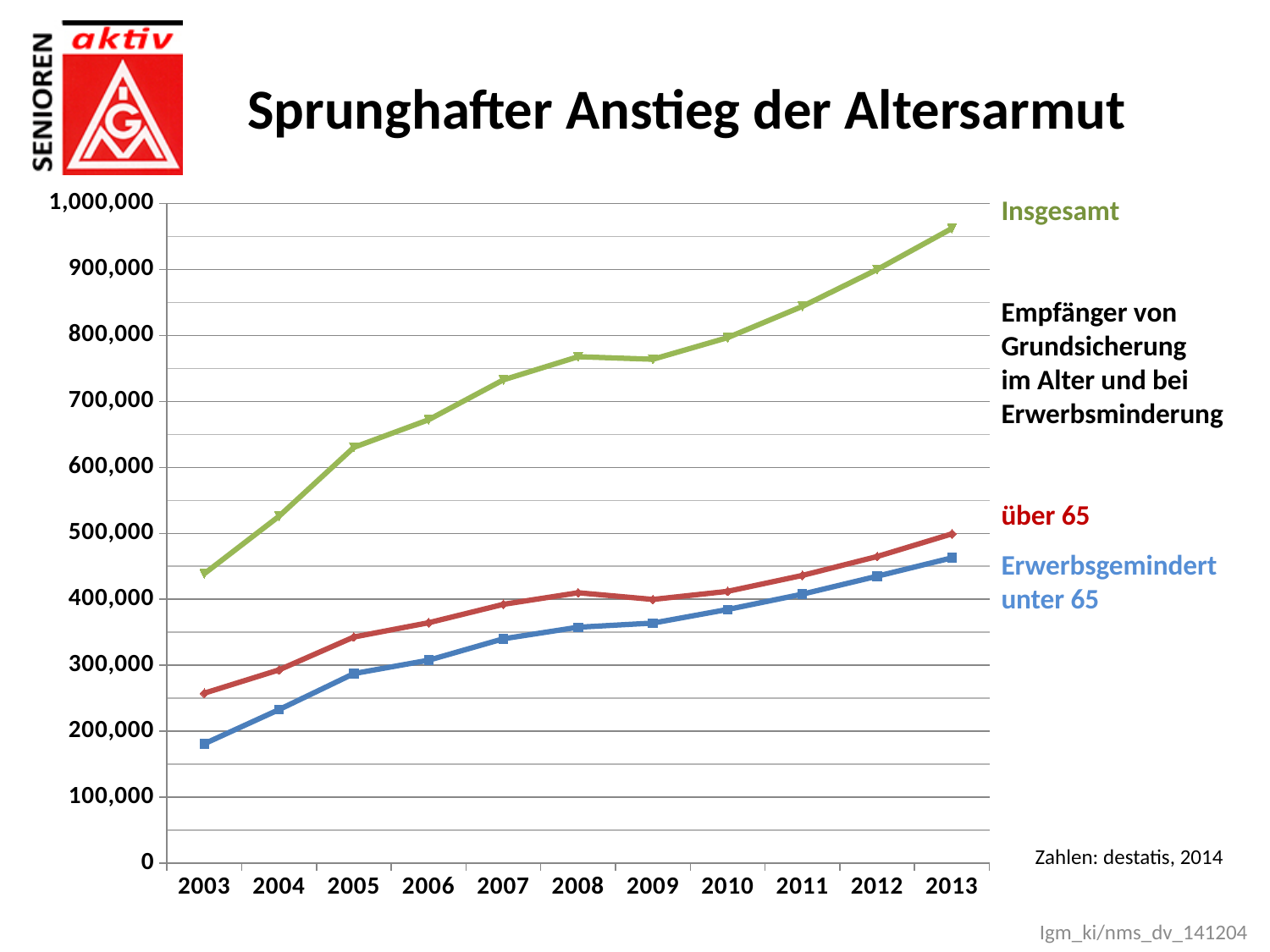
Is the Insgesamt value for 2003 greater or less than 500,000? less Is the Erwerbsgemindert unter 65 value for 2003 greater or less than 200,000? less How many series are plotted in the chart? 3 Does the Insgesamt line rise or fall from 2003 to 2013? rise In which year is the Insgesamt value highest? 2013 In 2010, which is larger: the Insgesamt value or the über 65 value? Insgesamt In which year is the Erwerbsgemindert unter 65 value lowest? 2003 What kind of chart is shown on the slide? line chart Is the Insgesamt value for 2008 greater or less than 700,000? greater Which series is plotted with the green line? Insgesamt How many years are shown on the x axis of the chart? 11